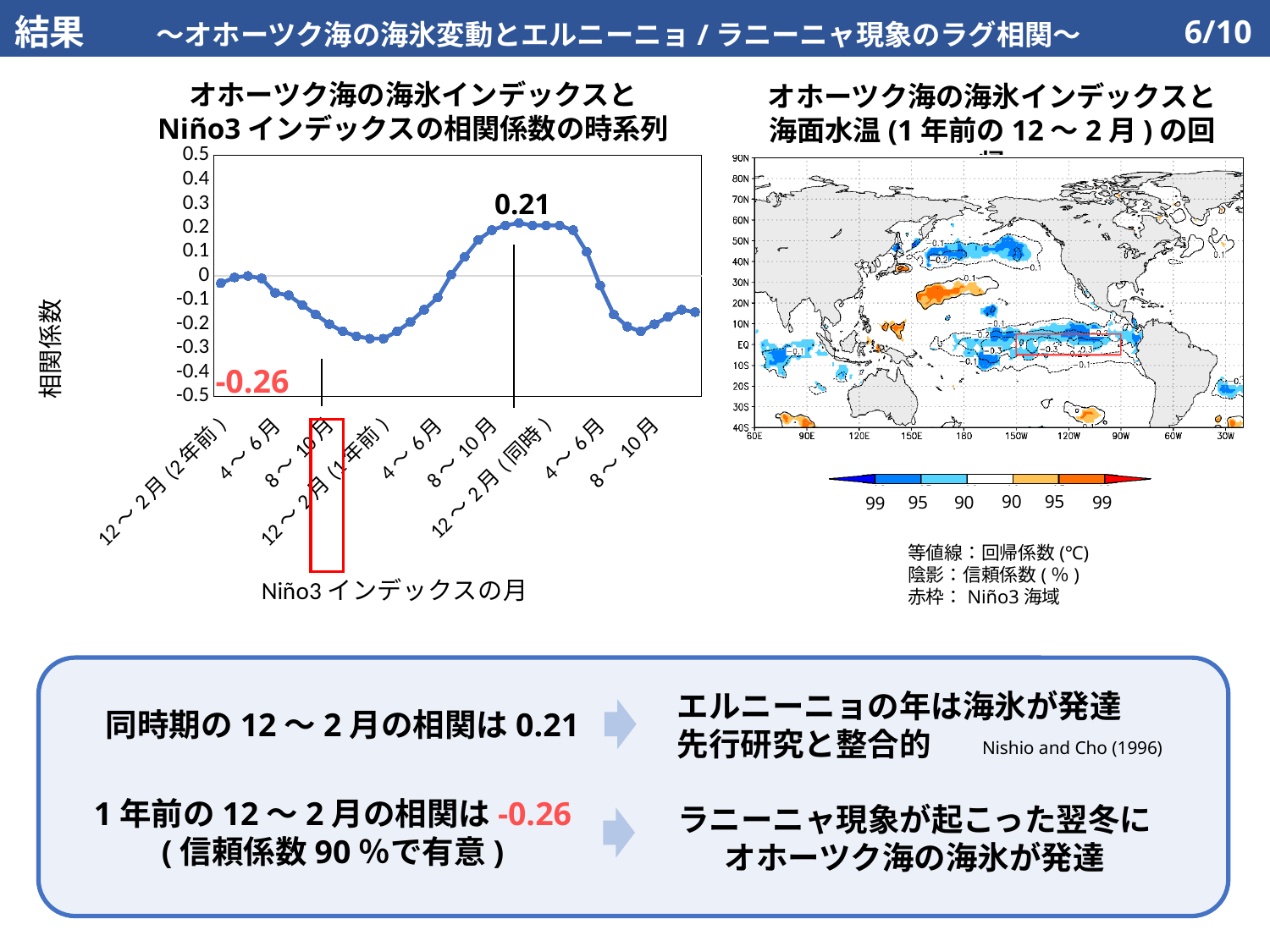
In the left line chart, what is the correlation coefficient labeled at 12～2月(1年前)? -0.26 What kind of chart is the left chart titled 'オホーツク海の海氷インデックスとNiño3インデックスの相関係数の時系列'? line chart In the left line chart, what is the correlation coefficient labeled at 12～2月(同時)? 0.21 In the left line chart, what is the difference between the labeled values 0.21 and -0.26? 0.47 In the left line chart, at which x-axis label does the correlation coefficient reach its lowest value? 12～2月(1年前) In the left line chart, does the correlation coefficient rise or fall from 12～2月(1年前) to 12～2月(同時)? rise In the left line chart, is the correlation coefficient at the first 8～10月 label (between 12～2月(2年前) and 12～2月(1年前)) greater or less than 0? less What is the y-axis label of the left line chart? 相関係数 How many x-axis labels are shown on the left line chart? 9 In the left line chart, is the correlation coefficient at the 8～10月 label just before 12～2月(同時) greater or less than 0? greater In the left line chart, which has the larger correlation coefficient: 12～2月(同時) or 12～2月(1年前)? 12～2月(同時)